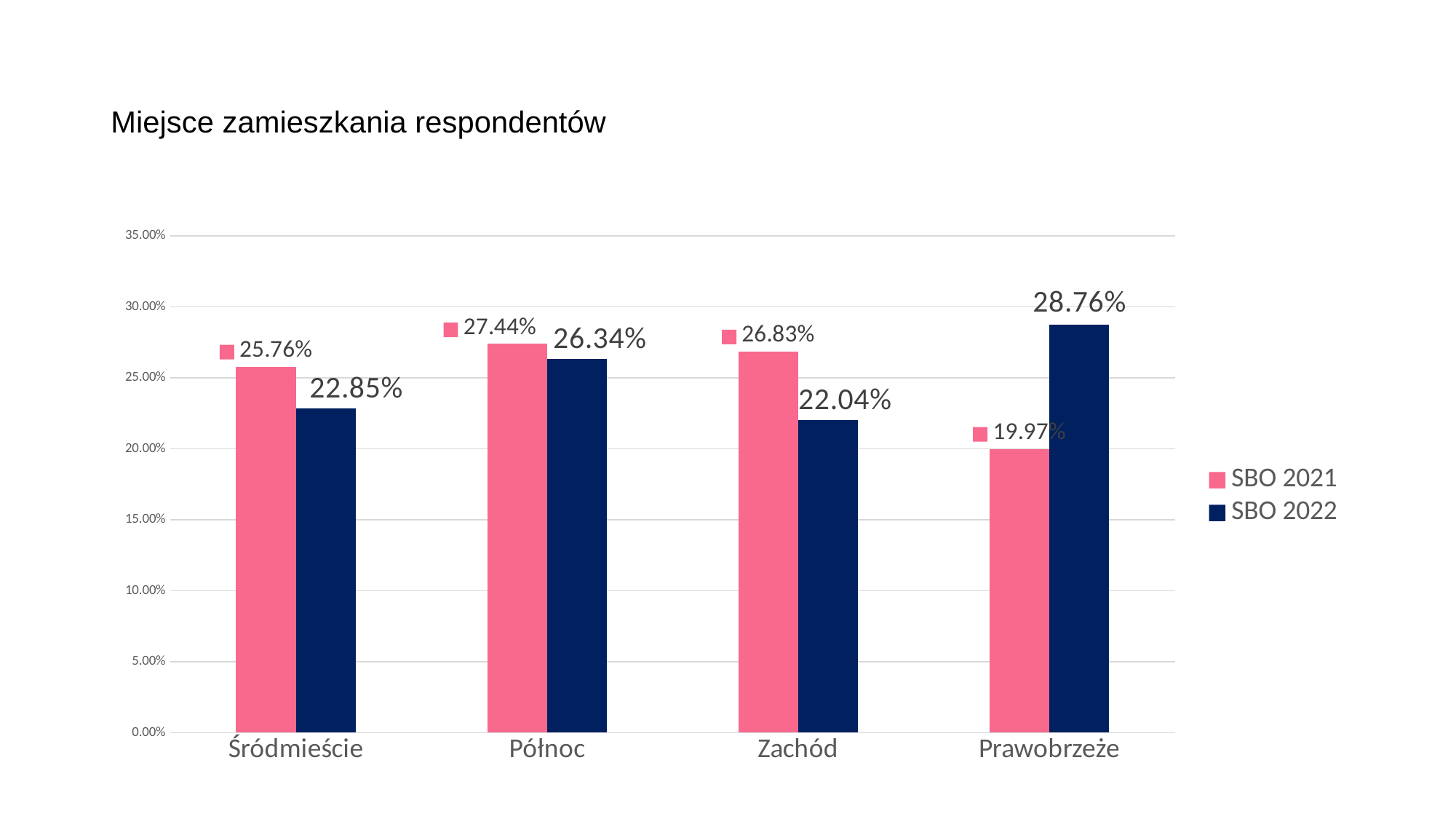
What kind of chart is shown on the slide? bar chart Which category has the highest SBO 2022 value? Prawobrzeże Which category has the lowest SBO 2021 value? Prawobrzeże What is the SBO 2022 value for Prawobrzeże? 28.76% How many categories are shown on the x axis? 4 What is the title of the chart? Miejsce zamieszkania respondentów What is the difference between the SBO 2022 and SBO 2021 values for Prawobrzeże? 8.79% What is the SBO 2022 value for Zachód? 22.04% What is the SBO 2021 value for Śródmieście? 25.76% How many series does the legend list? 2 Is the SBO 2021 value for Prawobrzeże greater or less than 20.00%? less Which is larger for Północ: the SBO 2021 value or the SBO 2022 value? SBO 2021